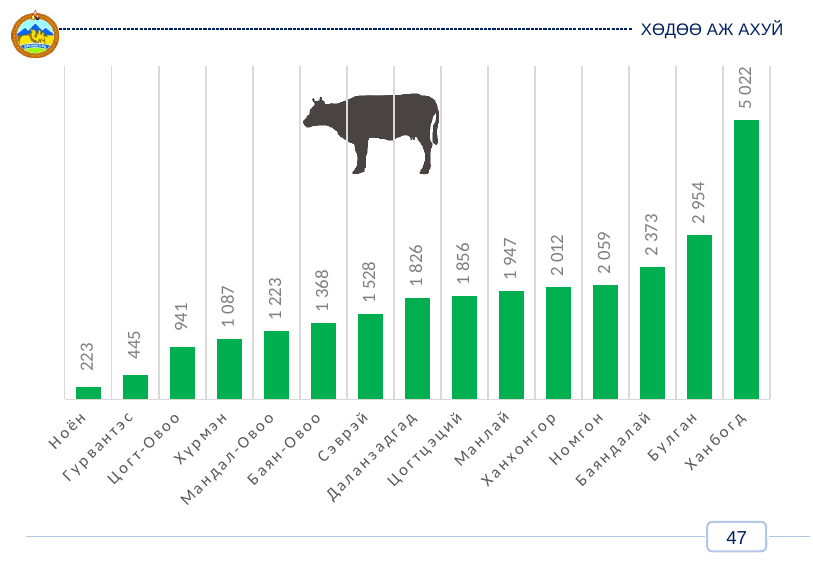
What is the value for Ханбогд? 5 022 Which is larger, the value for Сэврэй or the value for Баян-Овоо? Сэврэй What is the value for Даланзадгад? 1 826 What is the difference between the values for Ханбогд and Булган? 2 068 Which category has the highest value? Ханбогд Do the values rise or fall from left to right along the x axis? Rise What is the value for Баяндалай? 2 373 Which category has the lowest value? Ноён What is the value for Ноён? 223 What is the difference between the values for Гурвантэс and Ноён? 222 What kind of chart is shown on the slide? Bar chart How many categories are shown on the x axis? 15